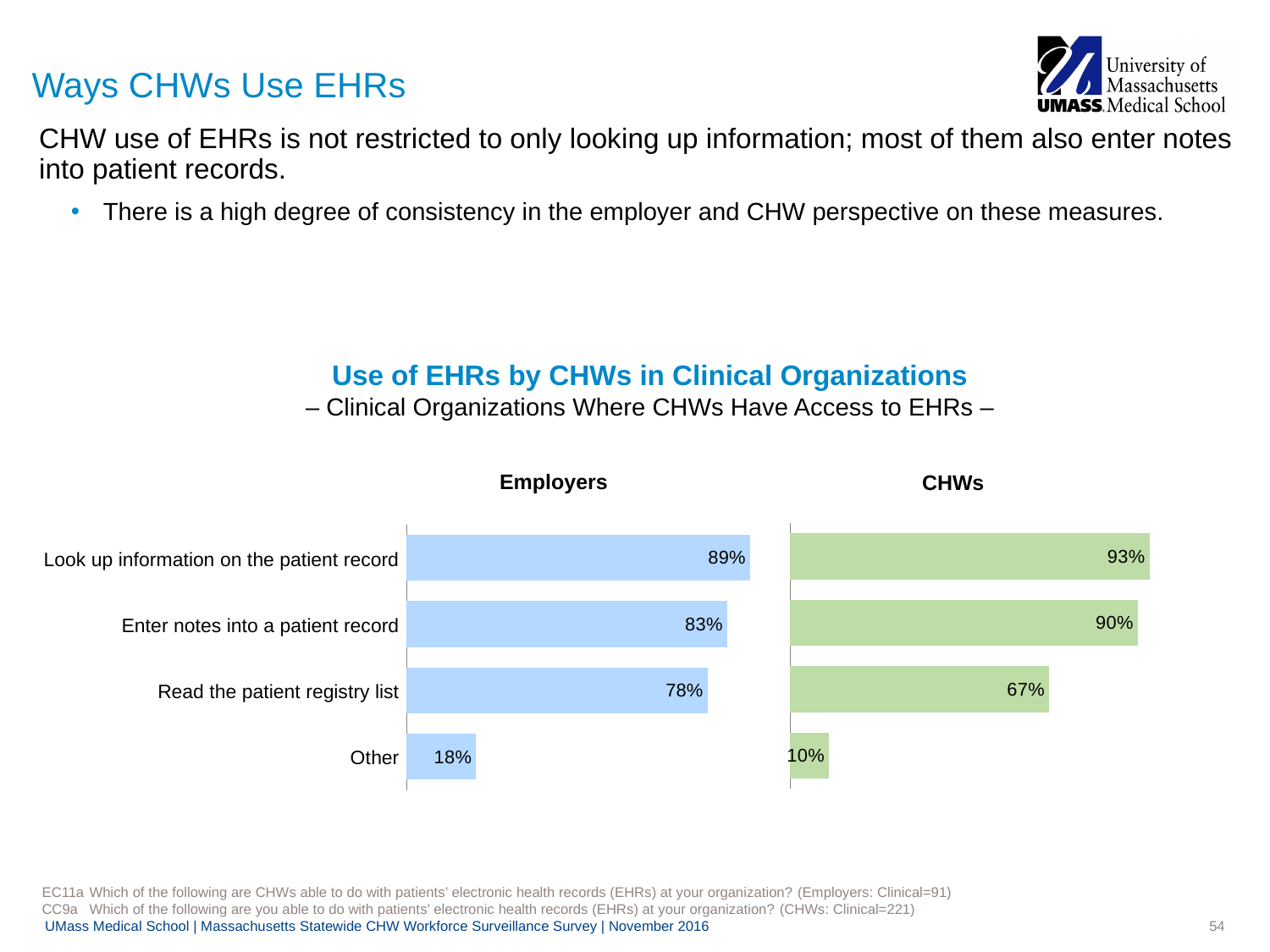
In the Employers chart, which category has the lowest value? Other In the Employers chart, what percentage is shown for 'Other'? 18% In the Employers chart, what percentage is shown for 'Look up information on the patient record'? 89% For 'Enter notes into a patient record', which is larger: the Employers value or the CHWs value? CHWs What is the title of the chart section on the slide? Use of EHRs by CHWs in Clinical Organizations In the CHWs chart, which category has the highest value? Look up information on the patient record In the CHWs chart, what percentage is shown for 'Read the patient registry list'? 67% What type of chart is used to show the Employers data? Bar chart What is the difference between the Employers and CHWs values for 'Read the patient registry list'? 11 percentage points In the CHWs chart, what percentage is shown for 'Enter notes into a patient record'? 90% What is the difference between the Employers and CHWs values for 'Other'? 8 percentage points How many categories are shown in the Employers chart? 4